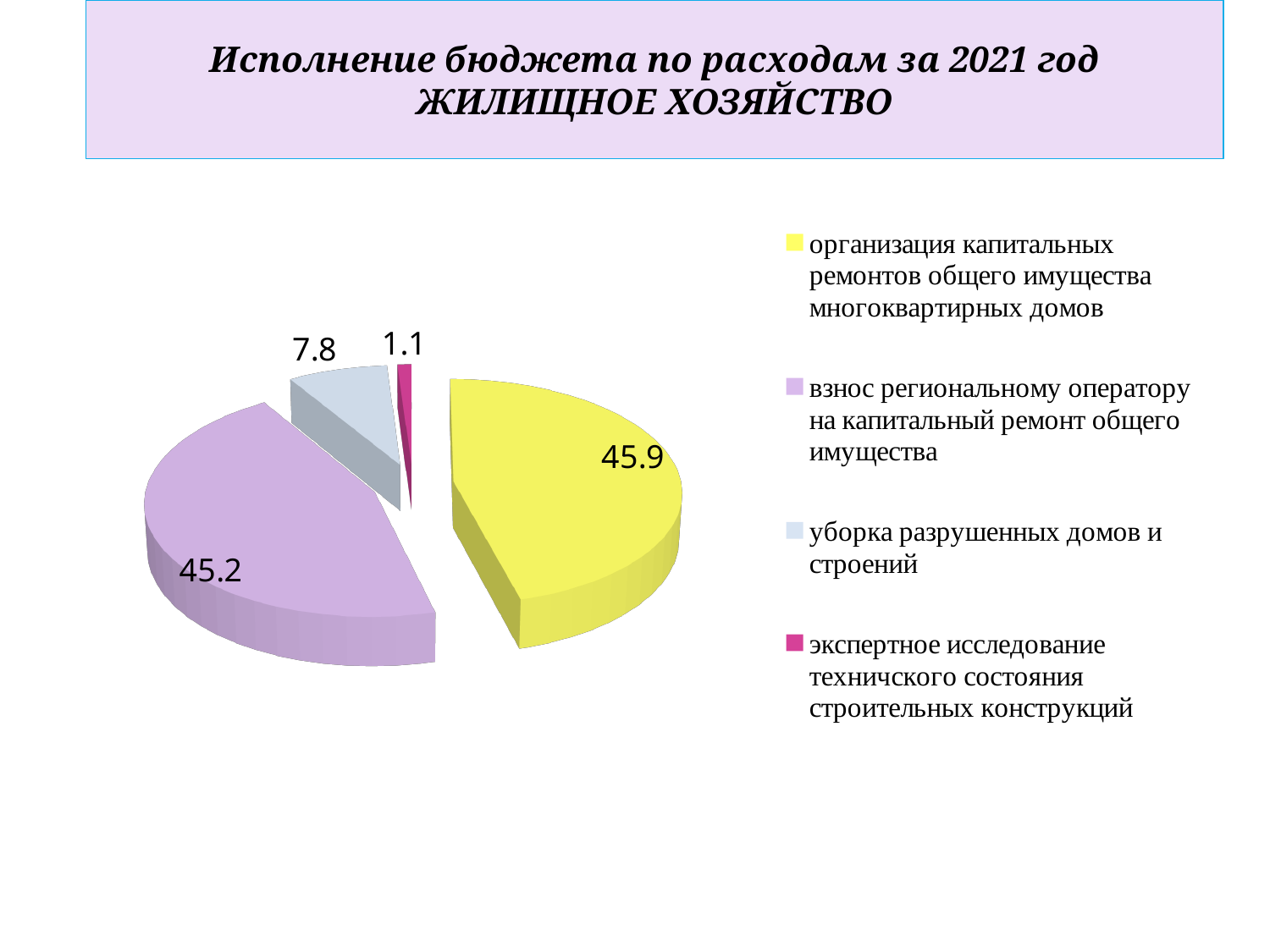
What colour is the slice for 'уборка разрушенных домов и строений'? light blue What is the value for 'организация капитальных ремонтов общего имущества многоквартирных домов'? 45.9 Which is larger: the value for 'взнос региональному оператору на капитальный ремонт общего имущества' or the value for 'уборка разрушенных домов и строений'? взнос региональному оператору на капитальный ремонт общего имущества What is the value for 'уборка разрушенных домов и строений'? 7.8 Which category has the largest slice of the pie? организация капитальных ремонтов общего имущества многоквартирных домов What is the difference between the values for 'организация капитальных ремонтов общего имущества многоквартирных домов' and 'взнос региональному оператору на капитальный ремонт общего имущества'? 0.7 What is the difference between the values for 'уборка разрушенных домов и строений' and 'экспертное исследование техничского состояния строительных конструкций'? 6.7 What is the value for 'экспертное исследование техничского состояния строительных конструкций'? 1.1 How many categories does the pie chart have? 4 What is the value for 'взнос региональному оператору на капитальный ремонт общего имущества'? 45.2 Which category has the smallest slice of the pie? экспертное исследование техничского состояния строительных конструкций What kind of chart is shown on the slide? pie chart